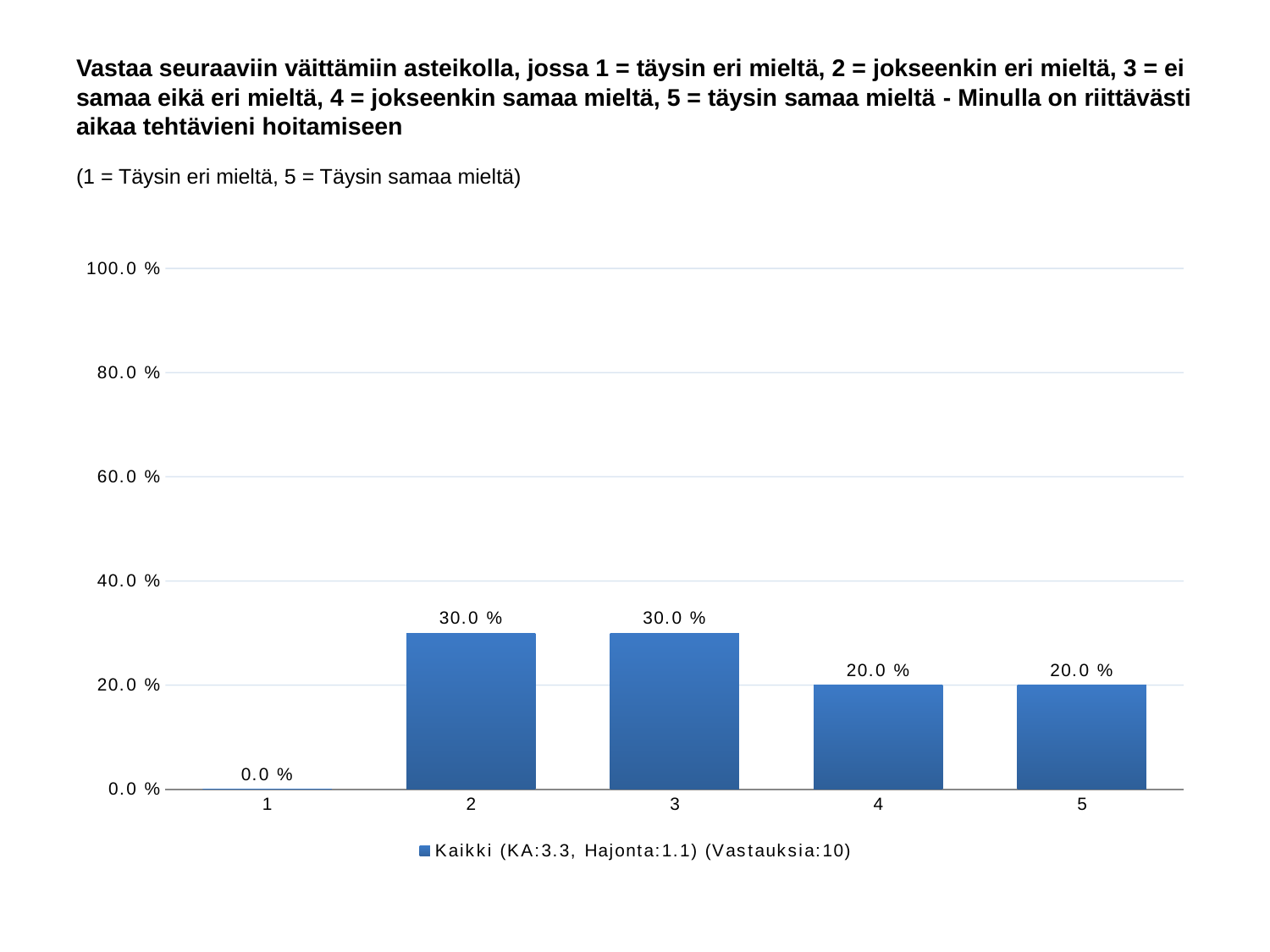
Which is larger, the value for category 2 or the value for category 5? 2 What kind of chart is shown? bar chart Is the value for category 3 greater or less than 40.0 %? less What is the legend entry for the series? Kaikki (KA:3.3, Hajonta:1.1) (Vastauksia:10) What is the value for category 1? 0.0 % What is the difference between the values for category 3 and category 4? 10.0 % How many series does the legend list? 1 How many categories are shown on the x axis? 5 What is the value for category 2? 30.0 % Which category has the lowest value? 1 What is the value for category 4? 20.0 % What is the value for category 5? 20.0 %